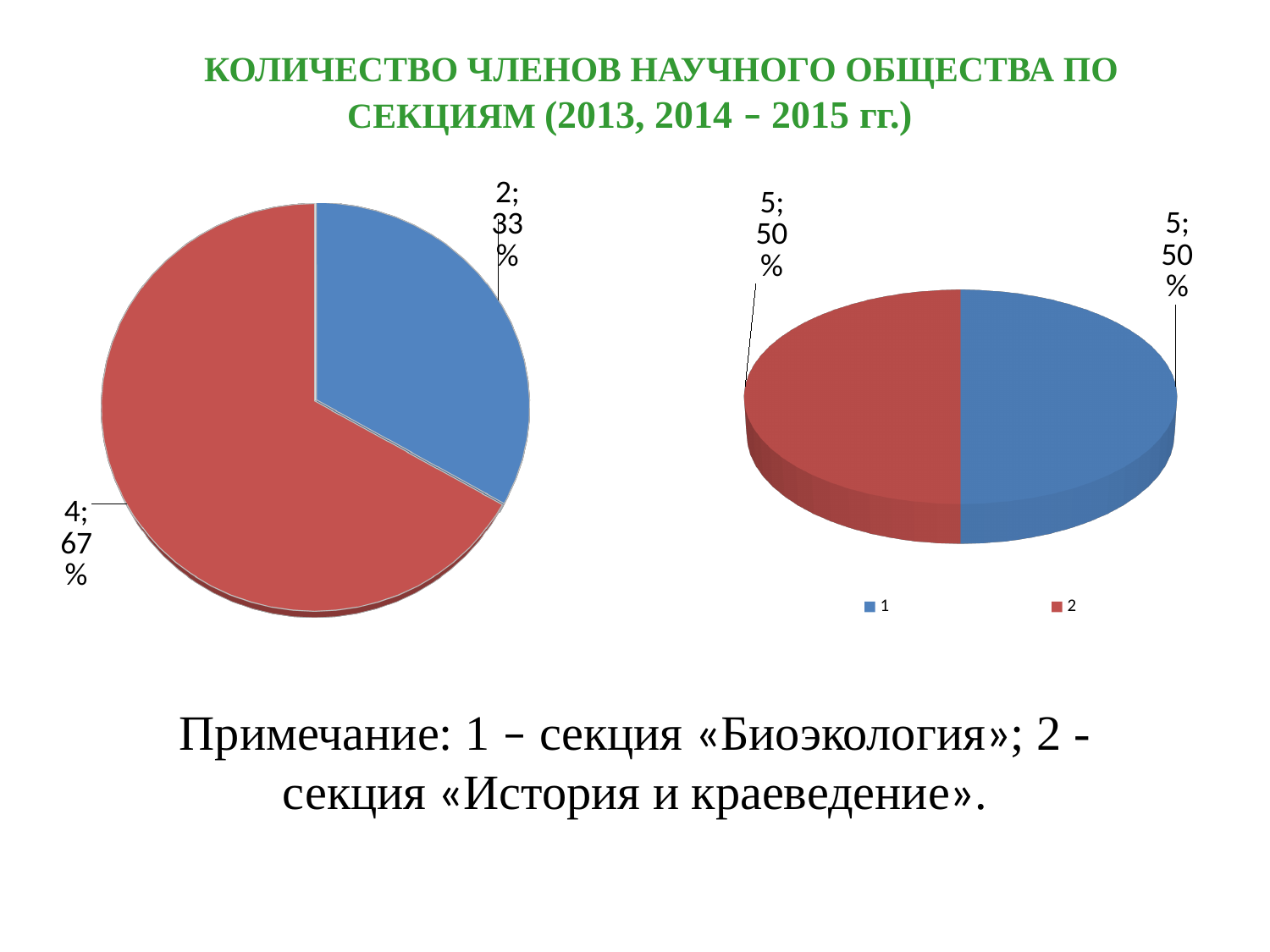
What kind of chart is the right chart on the slide? pie chart In the right pie chart, what value is shown for category 1? 5 In the left pie chart, what is the difference between the red slice's value and the blue slice's value? 2 What kind of chart is the left chart on the slide? pie chart In the left pie chart, what value is shown for the blue slice? 2 In the left pie chart, what share of the pie does the red slice represent? 67% How many entries does the legend of the right pie chart list? 2 How many slices does the left pie chart have? 2 In the right pie chart, what share of the pie does category 2 represent? 50% In the left pie chart, which slice is larger, the blue one or the red one? the red one In the left pie chart, what share of the pie does the blue slice represent? 33% In the left pie chart, what value is shown for the red slice? 4